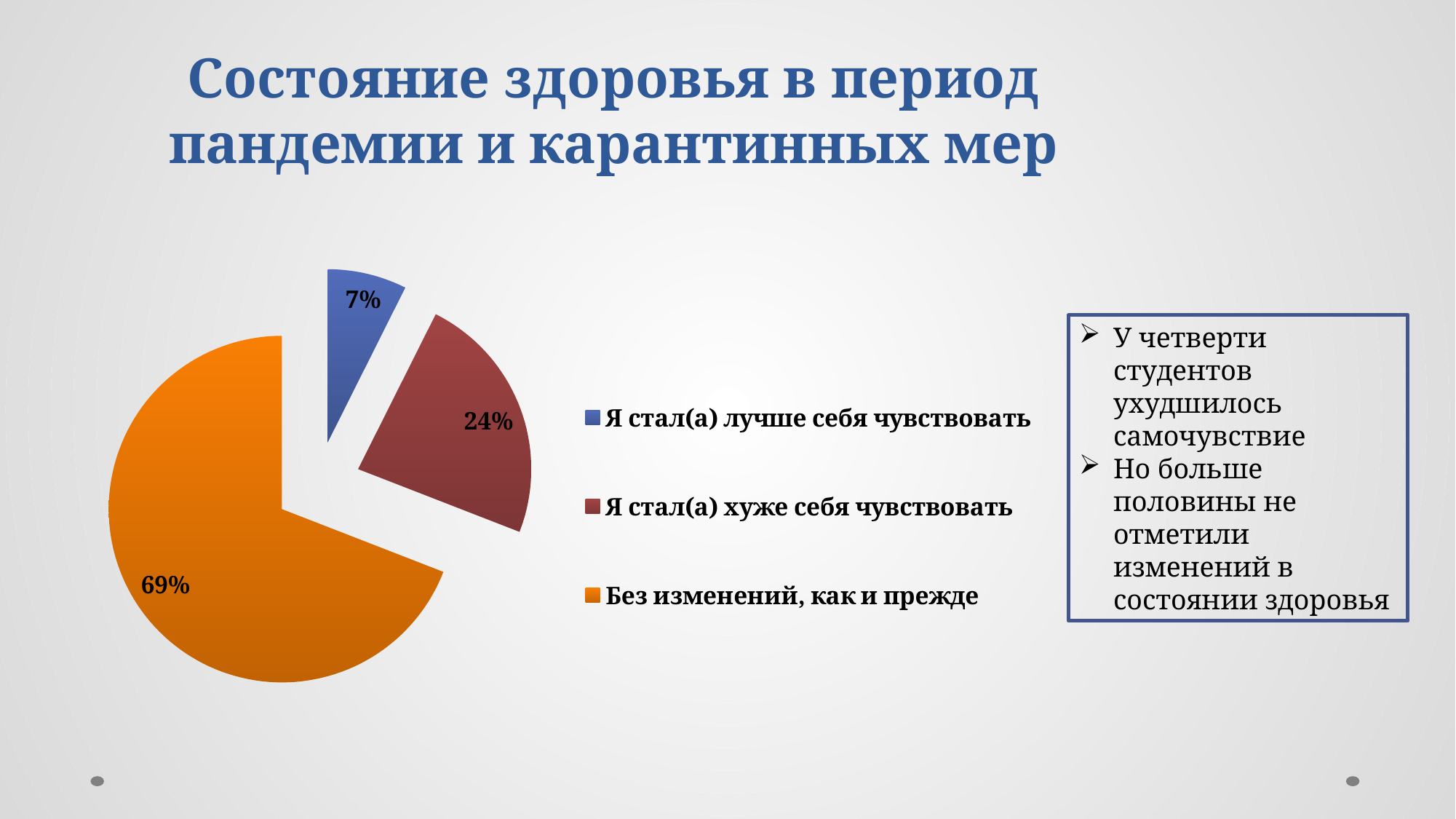
What share of the pie is labelled "Я стал(а) лучше себя чувствовать"? 7% What colour is the slice for "Без изменений, как и прежде"? orange What colour is the slice for "Я стал(а) лучше себя чувствовать"? blue What kind of chart is shown on the slide? pie chart Which category has the smallest slice of the pie? Я стал(а) лучше себя чувствовать What share of the pie is labelled "Без изменений, как и прежде"? 69% Which category has the largest slice of the pie? Без изменений, как и прежде Which is larger: the slice for "Я стал(а) хуже себя чувствовать" or the slice for "Я стал(а) лучше себя чувствовать"? Я стал(а) хуже себя чувствовать How many slices does the pie chart have? 3 What share of the pie is labelled "Я стал(а) хуже себя чувствовать"? 24% What is the difference in percentage points between "Без изменений, как и прежде" and "Я стал(а) хуже себя чувствовать"? 45 What is the difference in percentage points between "Я стал(а) хуже себя чувствовать" and "Я стал(а) лучше себя чувствовать"? 17